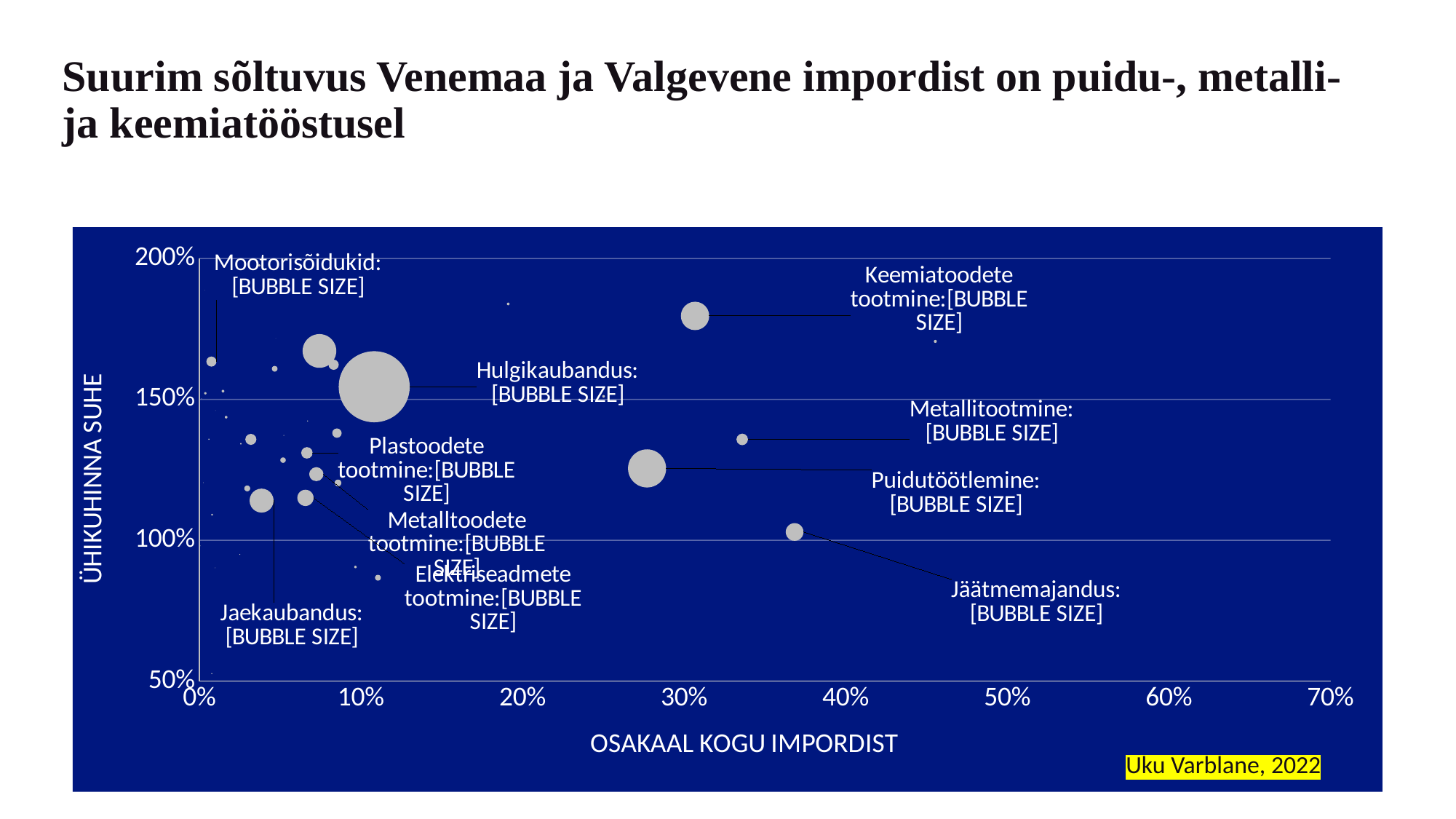
What is the title of the vertical axis of the chart? ÜHIKUHINNA SUHE What kind of chart is shown on the slide? Bubble chart Is the horizontal-axis value (share of total imports) for Keemiatoodete tootmine greater or less than 20%? greater Is the horizontal-axis value for Puidutöötlemine greater or less than 20%? greater What is the title of the horizontal axis of the chart? OSAKAAL KOGU IMPORDIST Is the horizontal-axis value for Jaekaubandus greater or less than 10%? less Which labelled bubble is the largest in the chart? Hulgikaubandus Which labelled bubble has the highest vertical-axis value (unit price ratio)? Keemiatoodete tootmine